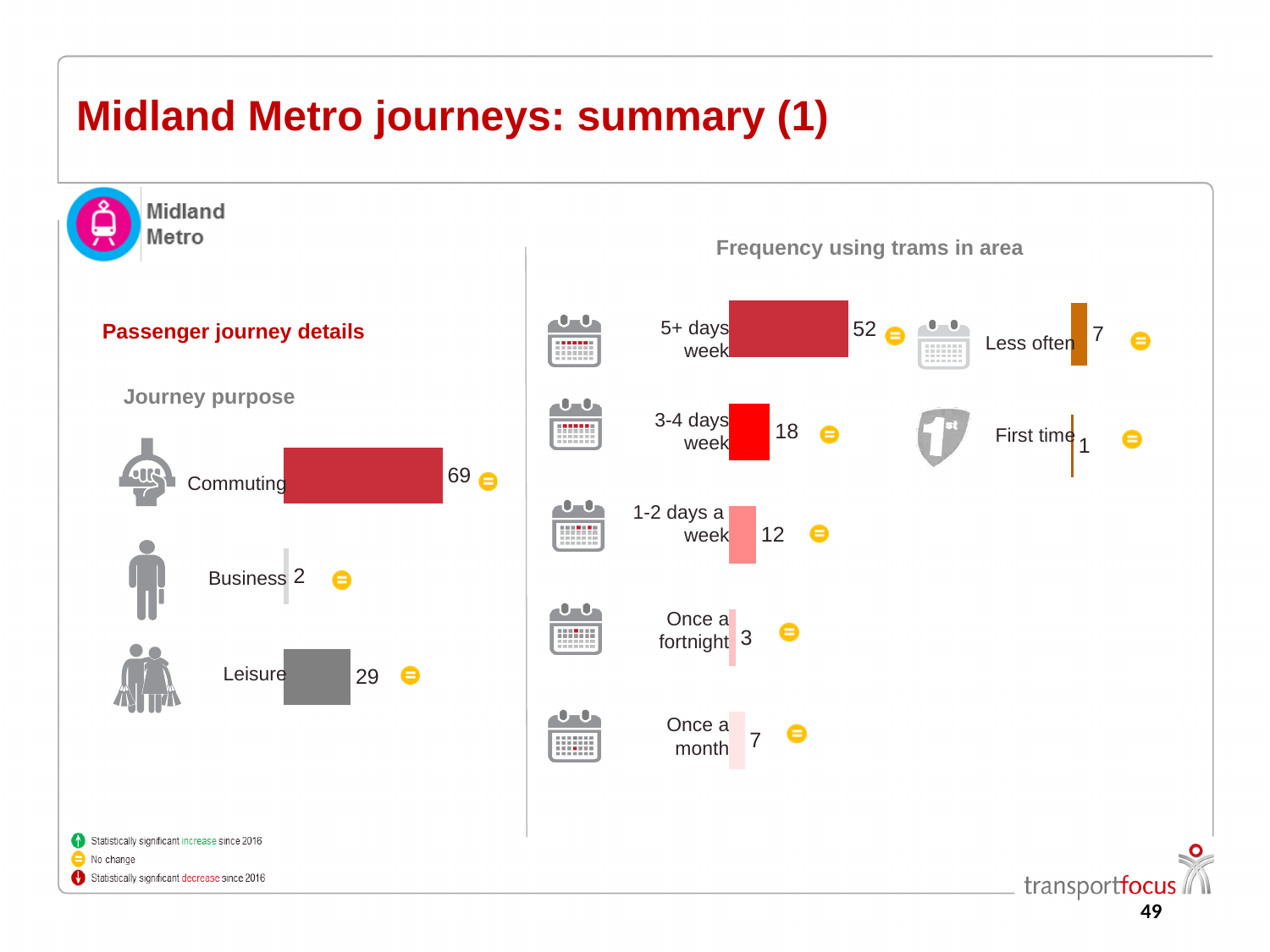
In the Frequency using trams in area chart, which category has the lowest value? First time In the Frequency using trams in area chart, what is the value for 1-2 days a week? 12 In the Frequency using trams in area chart, what is the value for 5+ days week? 52 In the Journey purpose chart, what is the value for Commuting? 69 In the Journey purpose chart, what is the difference between Commuting and Leisure? 40 In the Journey purpose chart, how many categories are shown? 3 In the Journey purpose chart, which category has the lowest value? Business What kind of chart is the Journey purpose chart? Bar chart In the Frequency using trams in area chart, which is larger: 3-4 days week or Once a month? 3-4 days week In the Frequency using trams in area chart, what is the difference between 3-4 days week and 1-2 days a week? 6 In the Journey purpose chart, what is the value for Leisure? 29 In the Frequency using trams in area chart, which category has the highest value? 5+ days week